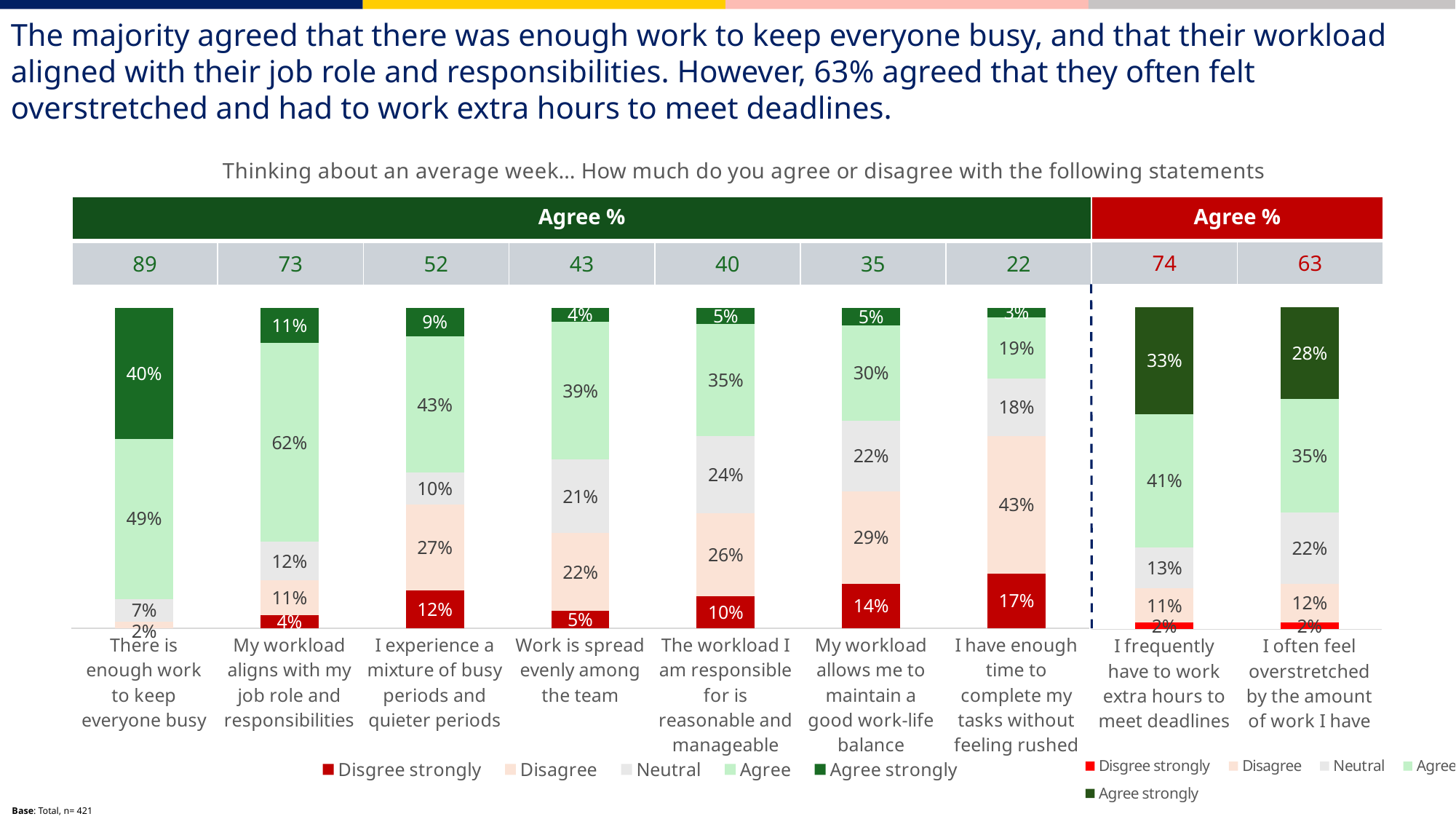
What is the 'Neutral' value for 'The workload I am responsible for is reasonable and manageable'? 24% What is the 'Agree %' figure shown above the bar for 'I frequently have to work extra hours to meet deadlines'? 74 Which statement has the largest 'Disagree strongly' value? I have enough time to complete my tasks without feeling rushed Which statement has the lowest 'Agree %' figure? I have enough time to complete my tasks without feeling rushed What kind of chart is shown on the slide? Stacked bar chart What is the 'Disagree' value for 'I have enough time to complete my tasks without feeling rushed'? 43% Which is larger: the 'Agree strongly' value for 'I frequently have to work extra hours to meet deadlines' or for 'I often feel overstretched by the amount of work I have'? I frequently have to work extra hours to meet deadlines What is the 'Agree strongly' value for 'There is enough work to keep everyone busy'? 40% How many statements (categories) are shown along the x axis of the chart? 9 Which statement has the highest 'Agree %' figure? There is enough work to keep everyone busy How many series does the chart's legend list? 5 What is the difference between the 'Agree' values for 'My workload aligns with my job role and responsibilities' and 'Work is spread evenly among the team'? 23%